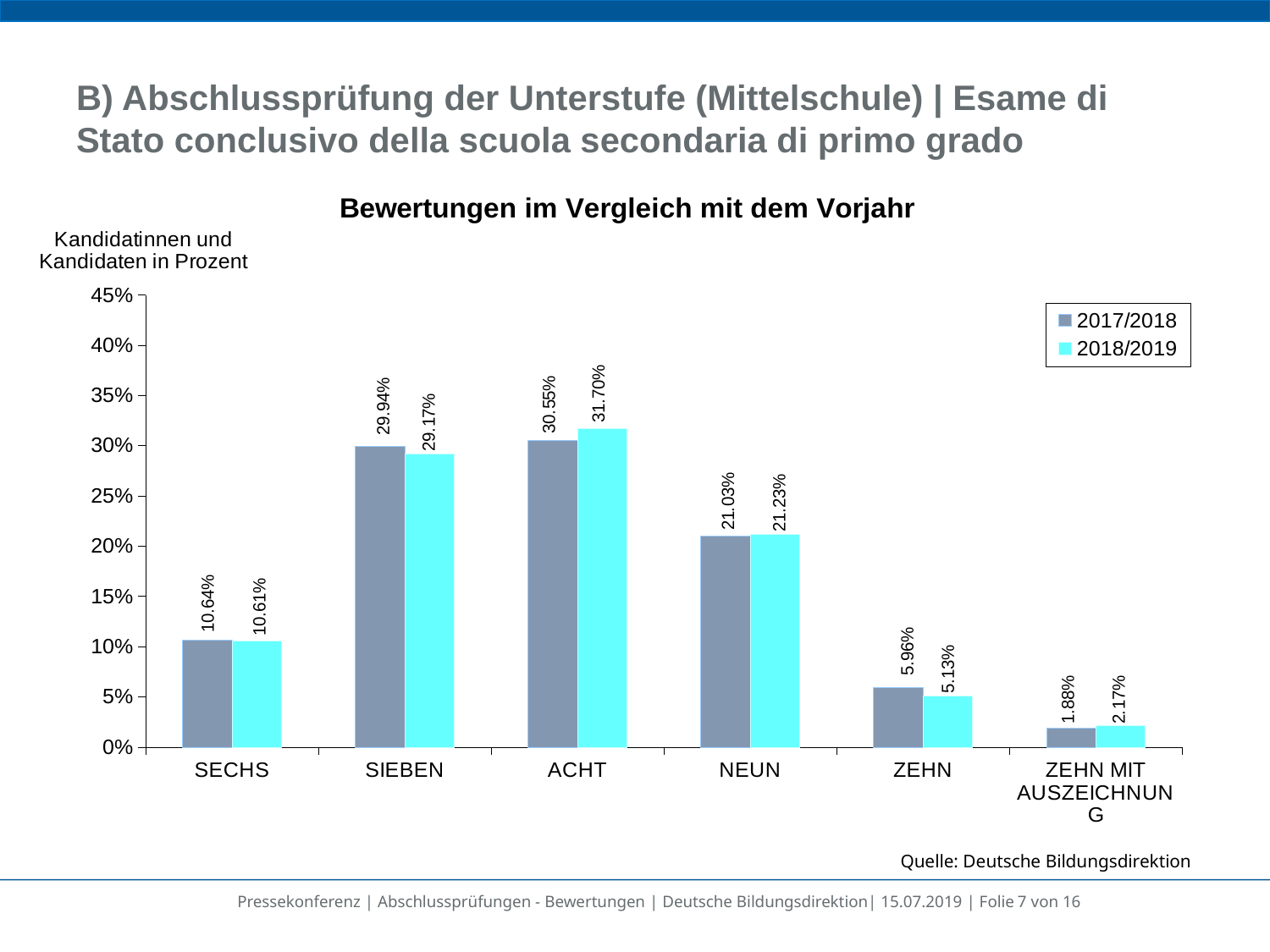
For SIEBEN, which series has the larger value, 2017/2018 or 2018/2019? 2017/2018 What is the value for ZEHN MIT AUSZEICHNUNG in the 2018/2019 series? 2.17% What kind of chart is shown on the slide? Bar chart Which category has the highest value in the 2018/2019 series? ACHT What is the difference between the 2018/2019 and 2017/2018 values for ACHT? 1.15% What is the title of the chart? Bewertungen im Vergleich mit dem Vorjahr What is the difference between the 2017/2018 and 2018/2019 values for ZEHN? 0.83% Which category has the lowest value in the 2017/2018 series? ZEHN MIT AUSZEICHNUNG What is the value for ACHT in the 2018/2019 series? 31.70% How many categories are shown on the x axis? 6 How many series does the legend list? 2 What is the value for SECHS in the 2017/2018 series? 10.64%